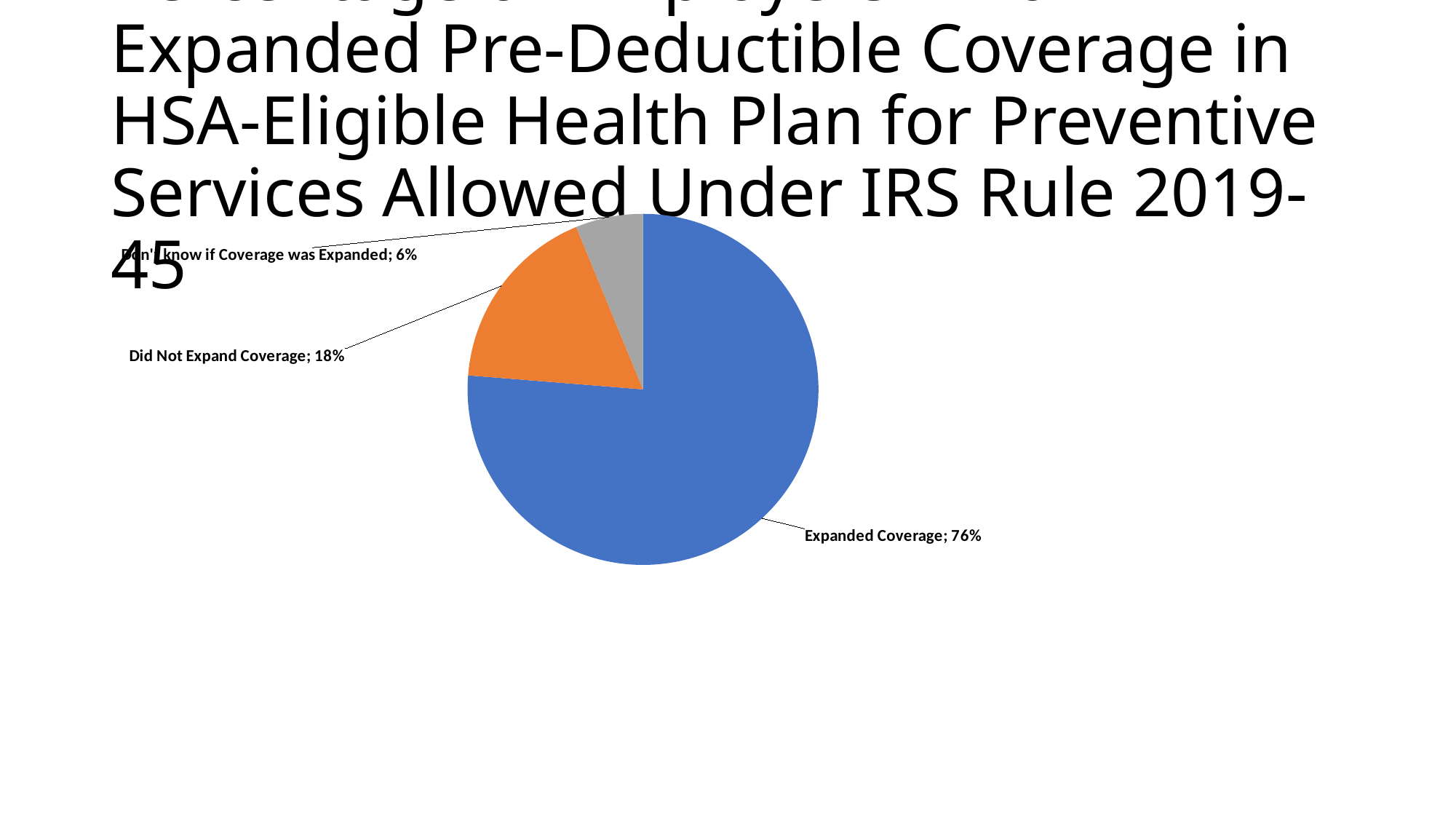
What kind of chart is shown on the slide? pie chart What is the difference in percentage points between Expanded Coverage and Did Not Expand Coverage? 58 What colour is the Expanded Coverage slice? blue What percentage of employers Expanded Coverage? 76% What is the difference in percentage points between Did Not Expand Coverage and Don't know if Coverage was Expanded? 12 How many slices does the pie chart have? 3 Which category has the smallest share of the pie? Don't know if Coverage was Expanded Which category has the largest share of the pie? Expanded Coverage What percentage of employers Don't know if Coverage was Expanded? 6% What colour is the Did Not Expand Coverage slice? orange What percentage of employers Did Not Expand Coverage? 18% Which is larger: Did Not Expand Coverage or Don't know if Coverage was Expanded? Did Not Expand Coverage